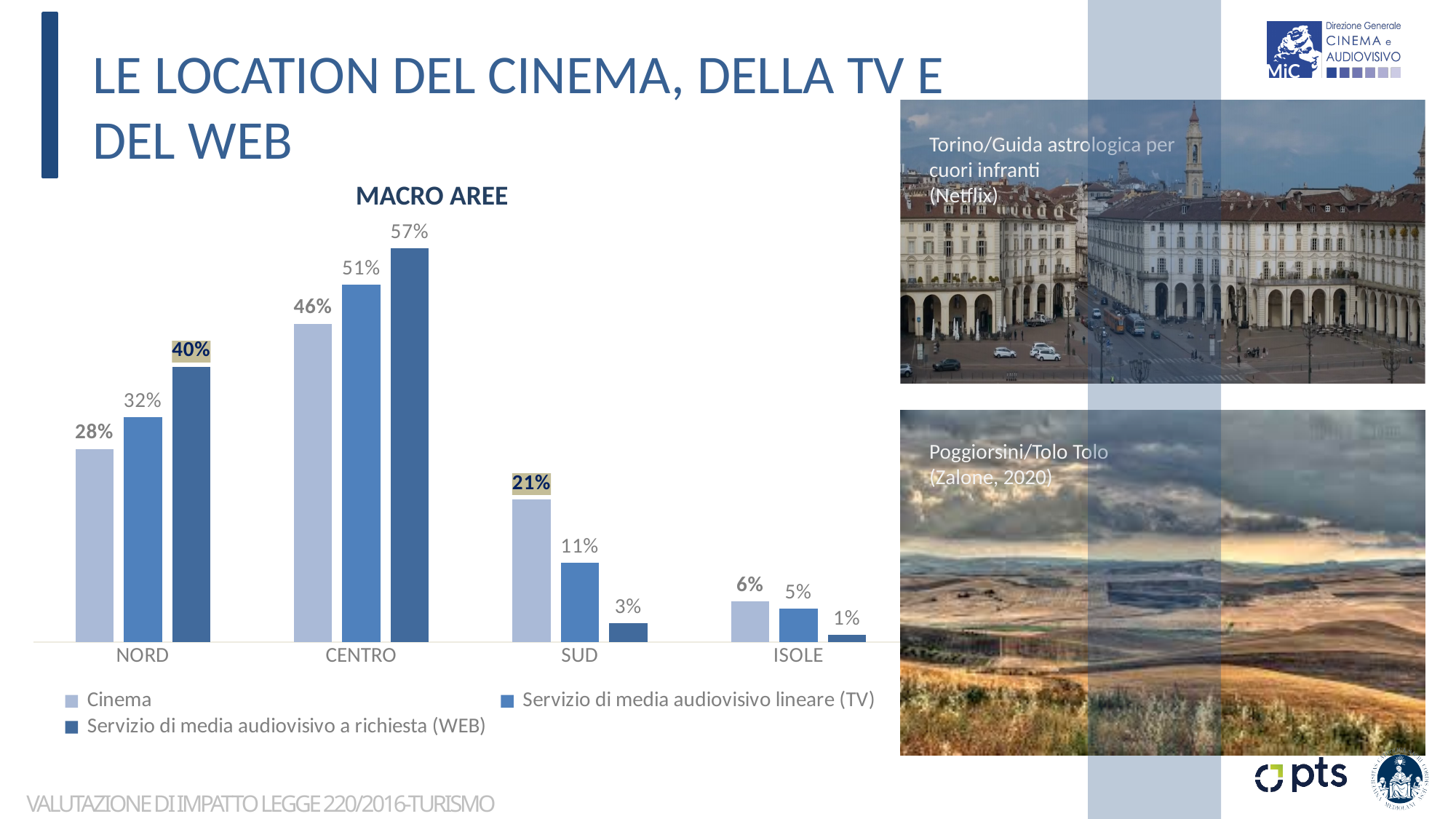
What is the title of the chart? MACRO AREE What is the Cinema value for NORD? 28% Which macro area has the highest Cinema value? CENTRO Which is larger in SUD: the Cinema value or the TV value? Cinema What kind of chart is shown on the slide? Bar chart What is the value for Servizio di media audiovisivo lineare (TV) in SUD? 11% How many series does the legend list? 3 Which macro area has the lowest value for Servizio di media audiovisivo a richiesta (WEB)? ISOLE Do the Cinema values rise or fall from NORD to CENTRO to SUD to ISOLE? Rise then fall How many macro areas are shown on the x axis? 4 What is the difference between the WEB value and the Cinema value for NORD? 12% What is the value for Servizio di media audiovisivo a richiesta (WEB) in CENTRO? 57%